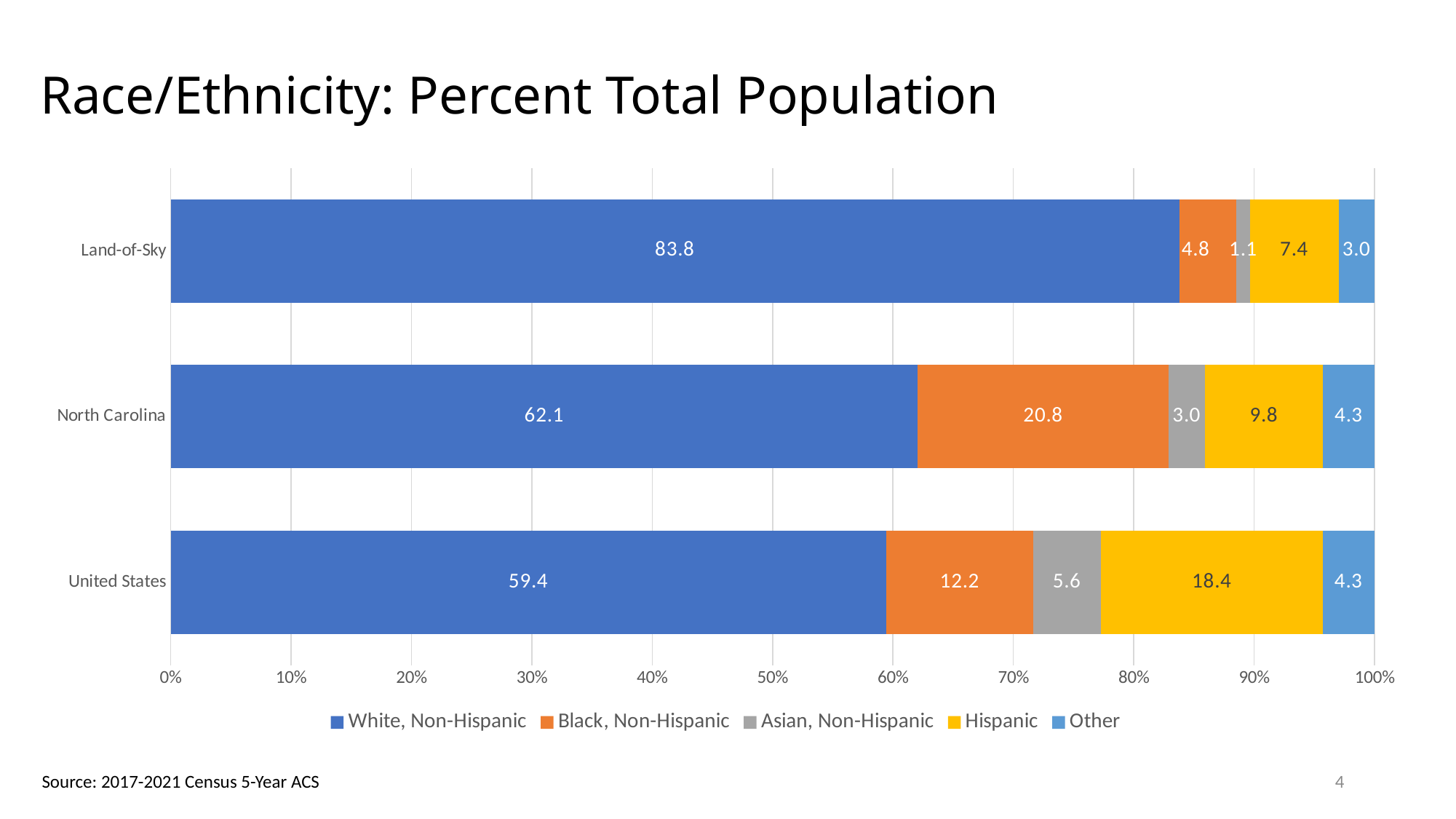
Which is larger, the Asian, Non-Hispanic value for the United States or for North Carolina? United States Which region has the lowest Hispanic value? Land-of-Sky What is the difference between the Black, Non-Hispanic values for North Carolina and the United States? 8.6 What is the Asian, Non-Hispanic value for Land-of-Sky? 1.1 How many series does the legend list? 5 What is the Hispanic value for the United States? 18.4 Which region has the highest White, Non-Hispanic value? Land-of-Sky What is the Black, Non-Hispanic value for North Carolina? 20.8 What is the White, Non-Hispanic value for Land-of-Sky? 83.8 What kind of chart is shown on the slide? Stacked bar chart How many regions are shown on the chart? 3 What is the title of the chart? Race/Ethnicity: Percent Total Population